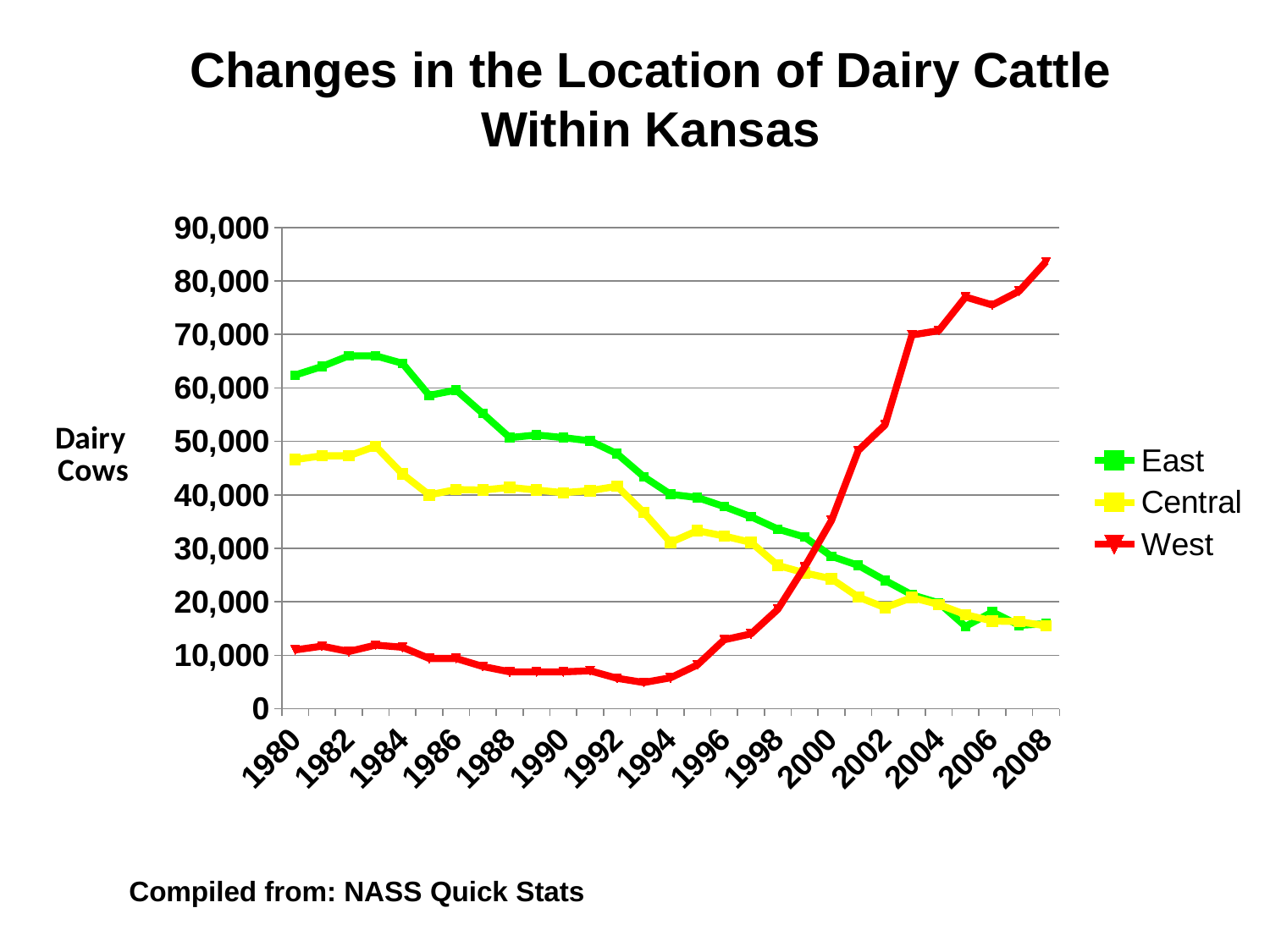
Is the value for West in 2008 greater or less than 80,000? greater What is the label on the vertical axis? Dairy Cows Does the East series rise or fall from 1980 to 2008? fall Which series has the lowest value in 1980? West What are the three series named in the legend? East, Central, West What kind of chart is shown on the slide? line chart How many series does the legend list? 3 Is the value for West in 1994 greater or less than 10,000? less Is the value for East in 1980 greater or less than 60,000? greater Which series has the highest value in 2008? West Does the West series rise or fall from 1980 to 2008? rise In 1980, which series has the larger value, East or West? East